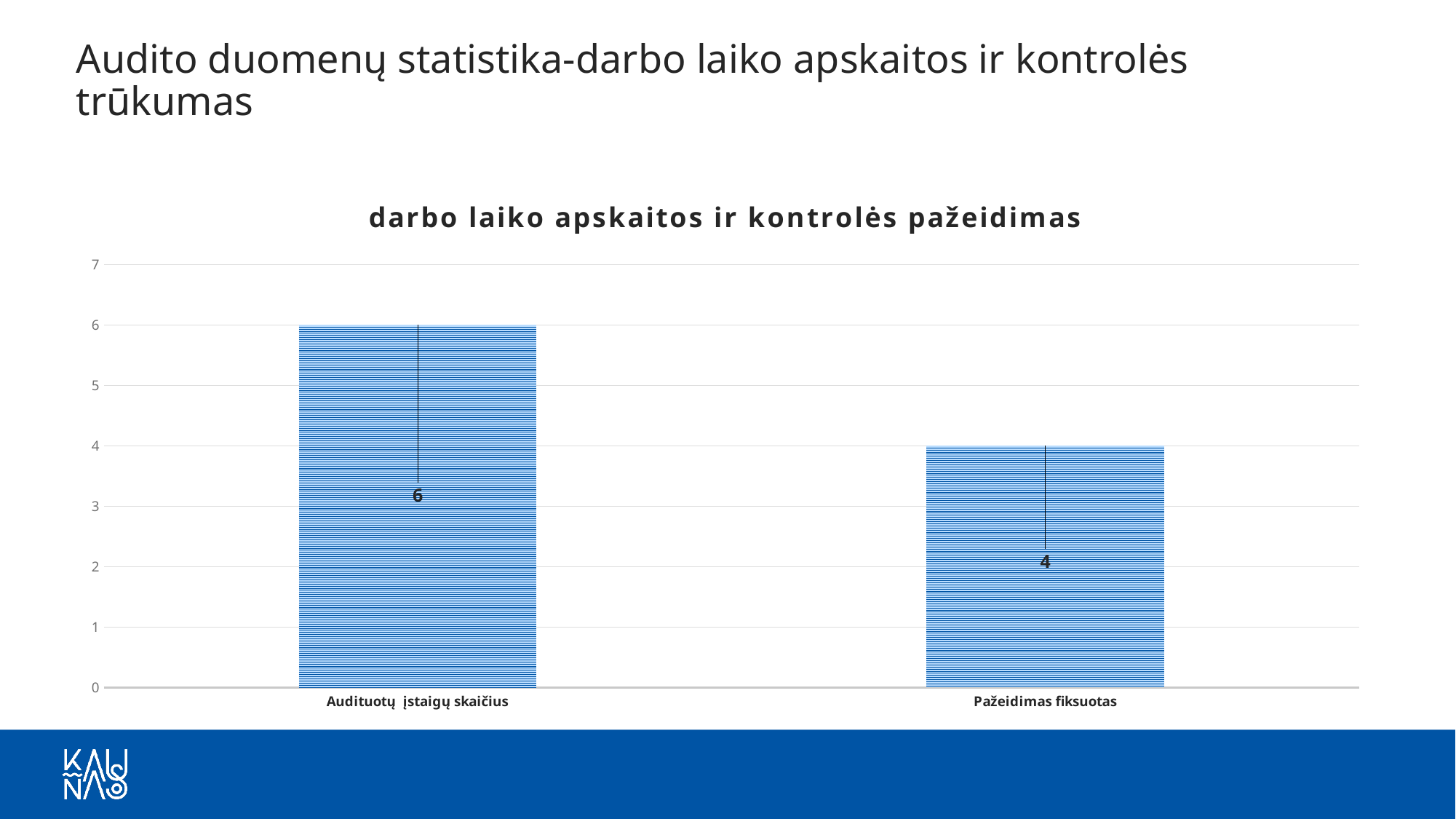
Is the value for Pažeidimas fiksuotas greater or less than 5? less What is the highest value shown on the vertical axis? 7 How many categories are shown on the chart? 2 Is the value for Audituotų įstaigų skaičius greater or less than 5? greater Which is larger, the value for Audituotų įstaigų skaičius or the value for Pažeidimas fiksuotas? Audituotų įstaigų skaičius What kind of chart is shown on the slide? bar chart Which category has the lowest value? Pažeidimas fiksuotas What is the value for Audituotų įstaigų skaičius? 6 What is the value for Pažeidimas fiksuotas? 4 What is the difference between the values for Audituotų įstaigų skaičius and Pažeidimas fiksuotas? 2 What is the title of the chart? darbo laiko apskaitos ir kontrolės pažeidimas Which category has the highest value? Audituotų įstaigų skaičius